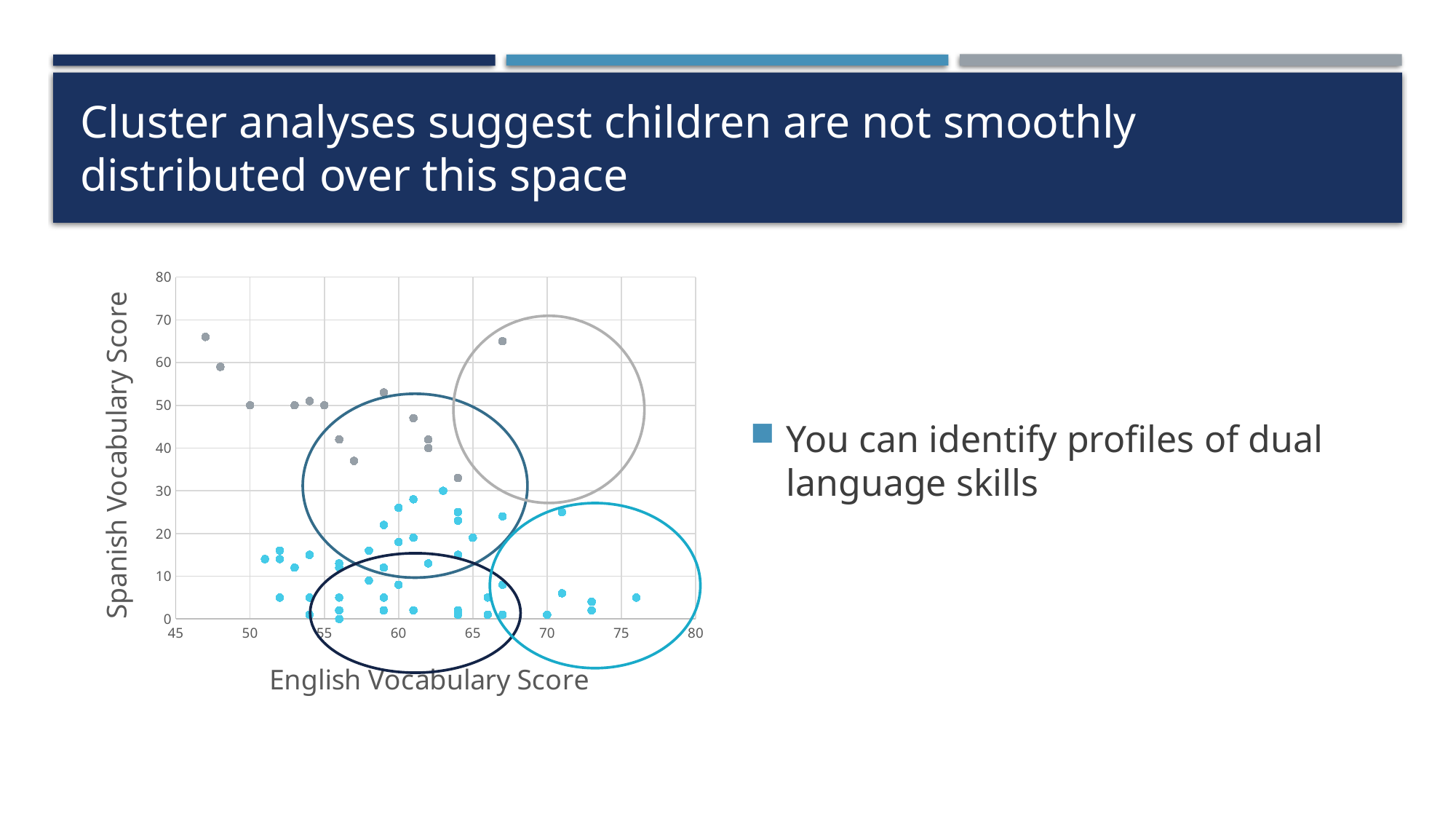
Is the highest English Vocabulary Score plotted on the chart greater or less than 70? greater Do the Spanish Vocabulary Scores of the gray points generally rise or fall as the English Vocabulary Score increases? fall Is the lowest English Vocabulary Score plotted on the chart greater or less than 50? less What is the title of the vertical axis of the chart? Spanish Vocabulary Score Is the Spanish Vocabulary Score of the point with the highest English Vocabulary Score greater or less than 10? less What is the maximum value shown on the vertical axis of the chart? 80 What is the title of the horizontal axis of the chart? English Vocabulary Score What kind of chart is shown on the slide? Scatter chart